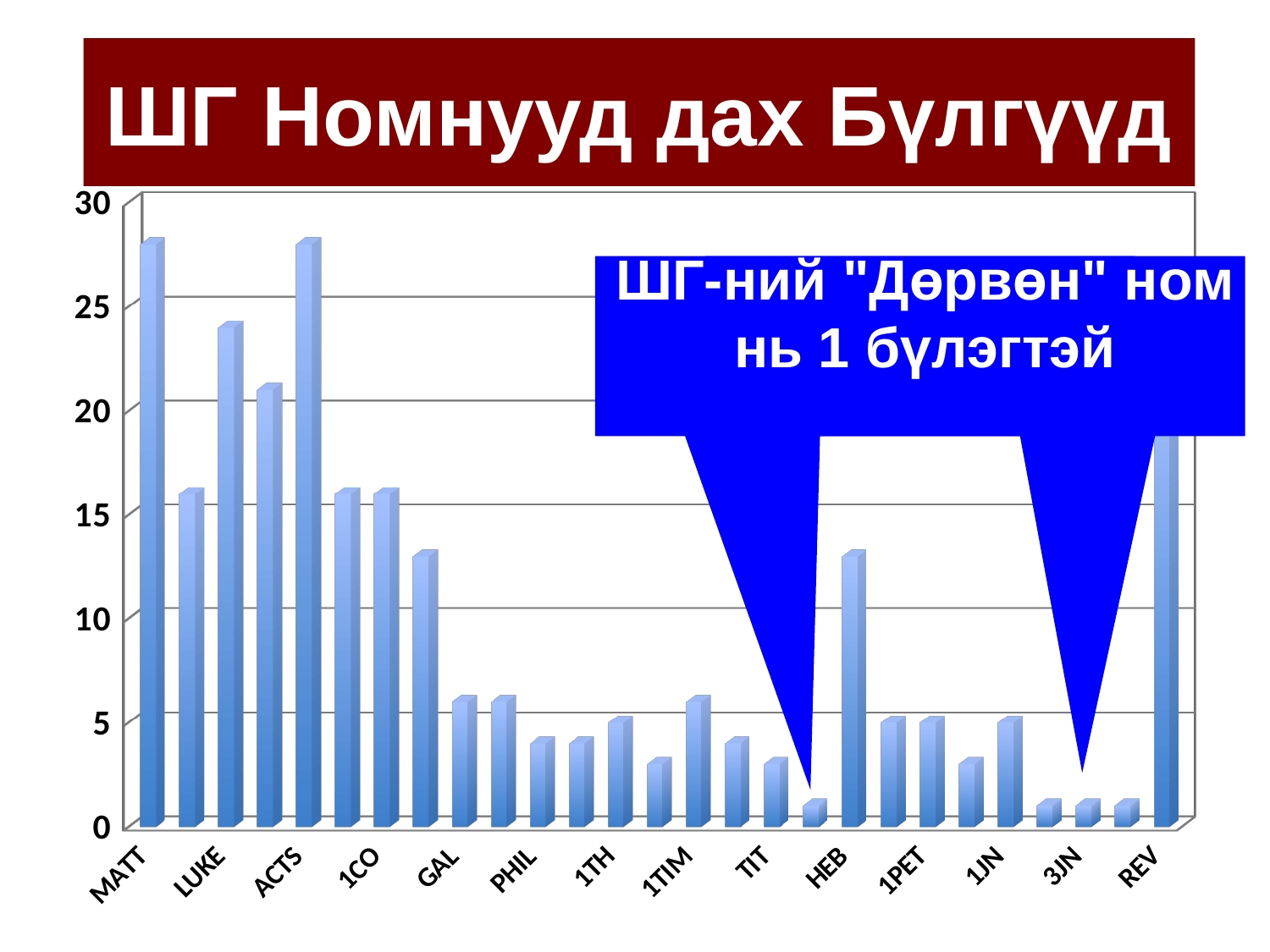
Is the value for HEB greater or less than 10? greater How many bars are plotted in the chart? 27 Which has the larger value, LUKE or HEB? LUKE Which has the larger value, GAL or TIT? GAL Is the value for MATT greater or less than 25? greater Is the value for TIT greater or less than 5? less What is the title of the chart on the slide? ШГ Номнууд дах Бүлгүүд What does the blue callout on the chart say? ШГ-ний "Дөрвөн" ном нь 1 бүлэгтэй What kind of chart is shown on the slide? bar chart